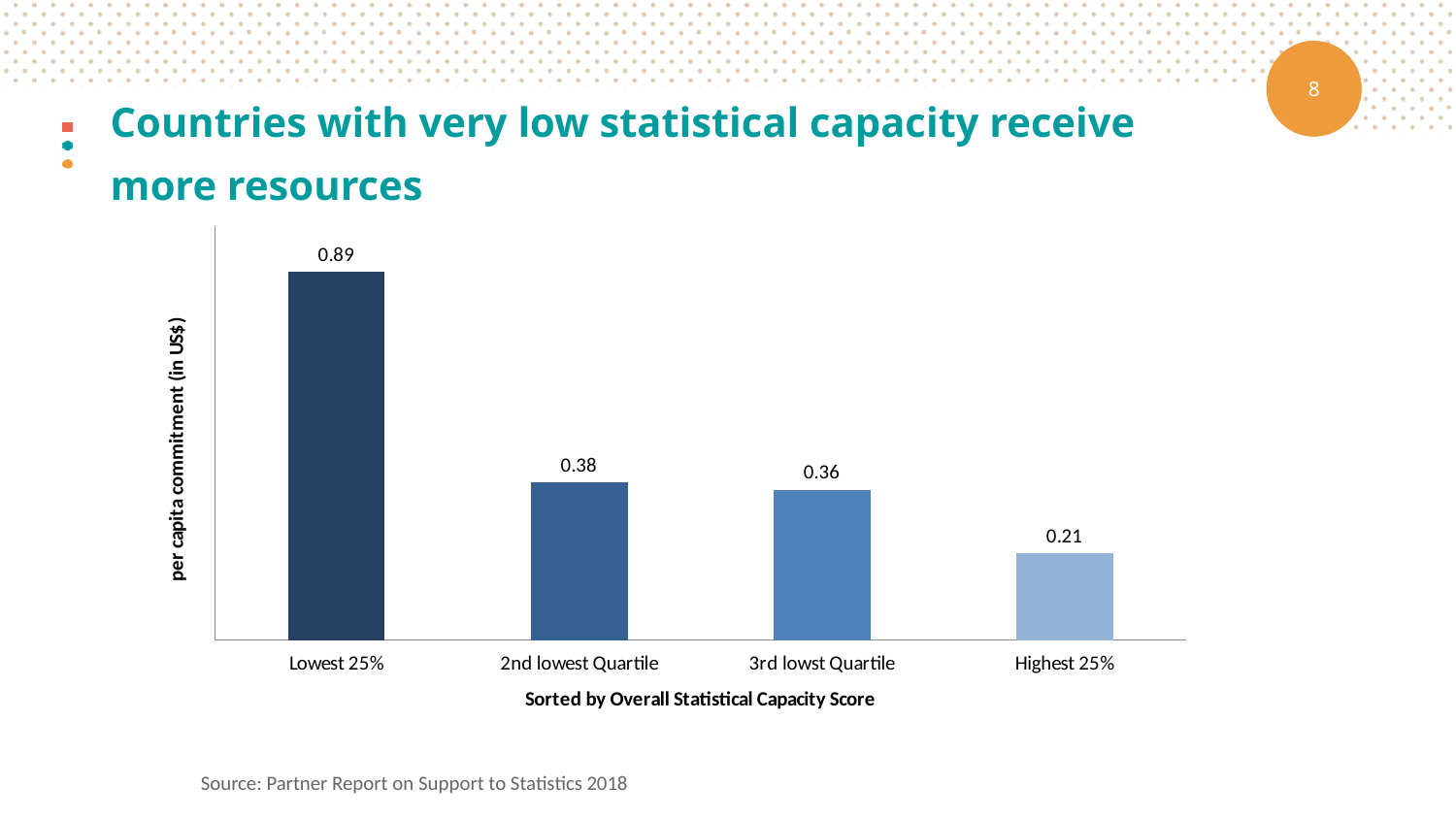
Which is larger, the value for the Lowest 25% or the value for the 2nd lowest Quartile? Lowest 25% What is the per capita commitment for the Highest 25% group? 0.21 What is the value shown for the 3rd lowst Quartile? 0.36 Which group has the highest per capita commitment? Lowest 25% Do the values rise or fall moving from left to right along the x axis? Fall What is the difference between the values for the 2nd lowest Quartile and the 3rd lowst Quartile? 0.02 How many groups are shown on the x axis? 4 What is the per capita commitment for the Lowest 25% group? 0.89 What type of chart is shown on the slide? Bar chart What is the value shown for the 2nd lowest Quartile? 0.38 What is the difference between the per capita commitment of the Lowest 25% and the Highest 25%? 0.68 Which group has the lowest per capita commitment? Highest 25%